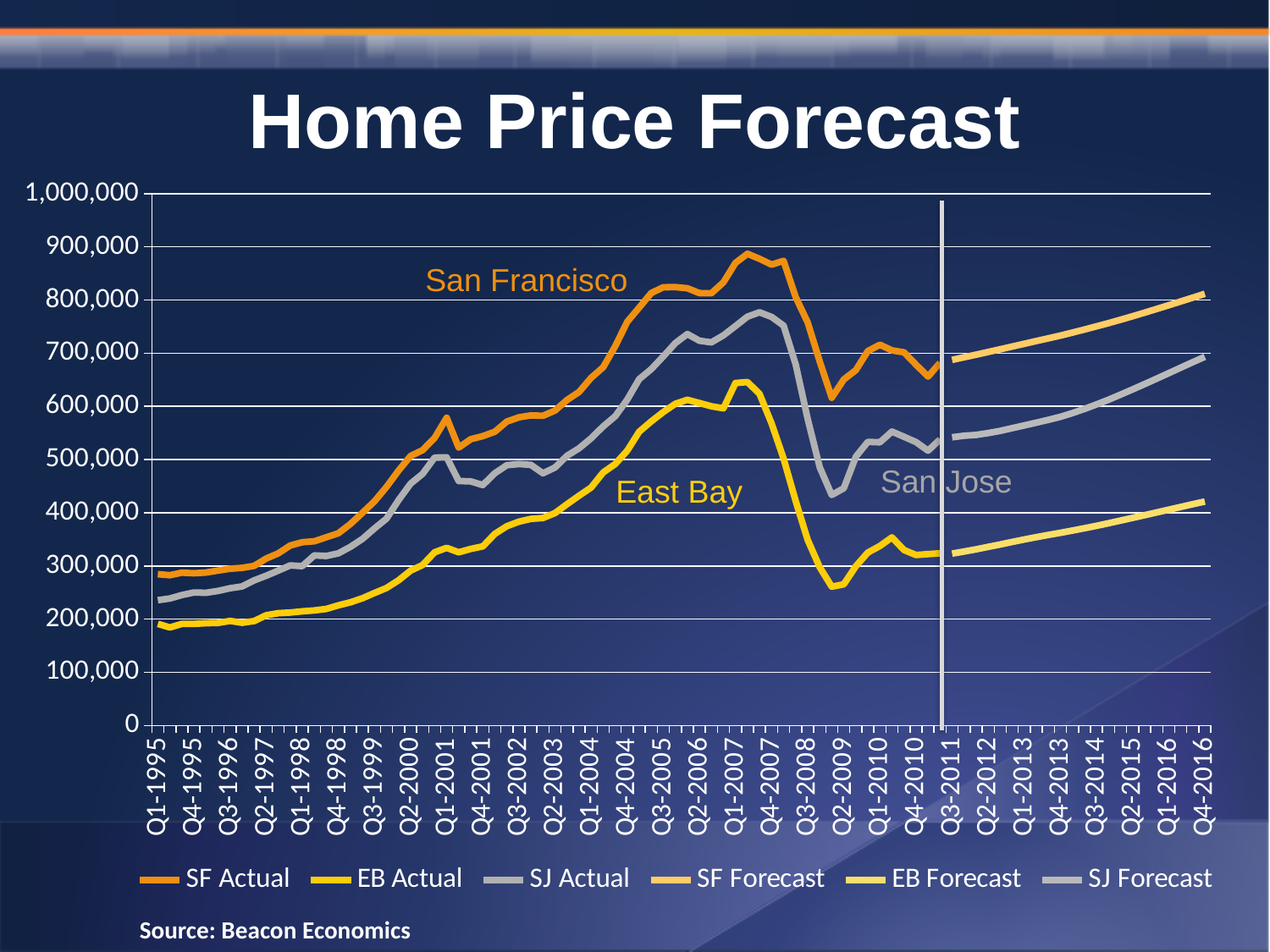
Which source is credited below the chart? Beacon Economics Which region's line is the lowest across the chart: San Francisco, East Bay or San Jose? East Bay What kind of chart is shown on the slide? line chart What is the title of the chart? Home Price Forecast How many series does the legend list? 6 Is the value for EB Actual at Q2-2009 greater or less than 300,000? less Which region's line is the highest across the chart: San Francisco, East Bay or San Jose? San Francisco Do the forecast lines rise or fall from Q3-2011 to Q4-2016? rise Is the value for SF Actual at Q1-2007 greater or less than 800,000? greater Is the value for EB Forecast at Q4-2016 greater or less than 400,000? greater